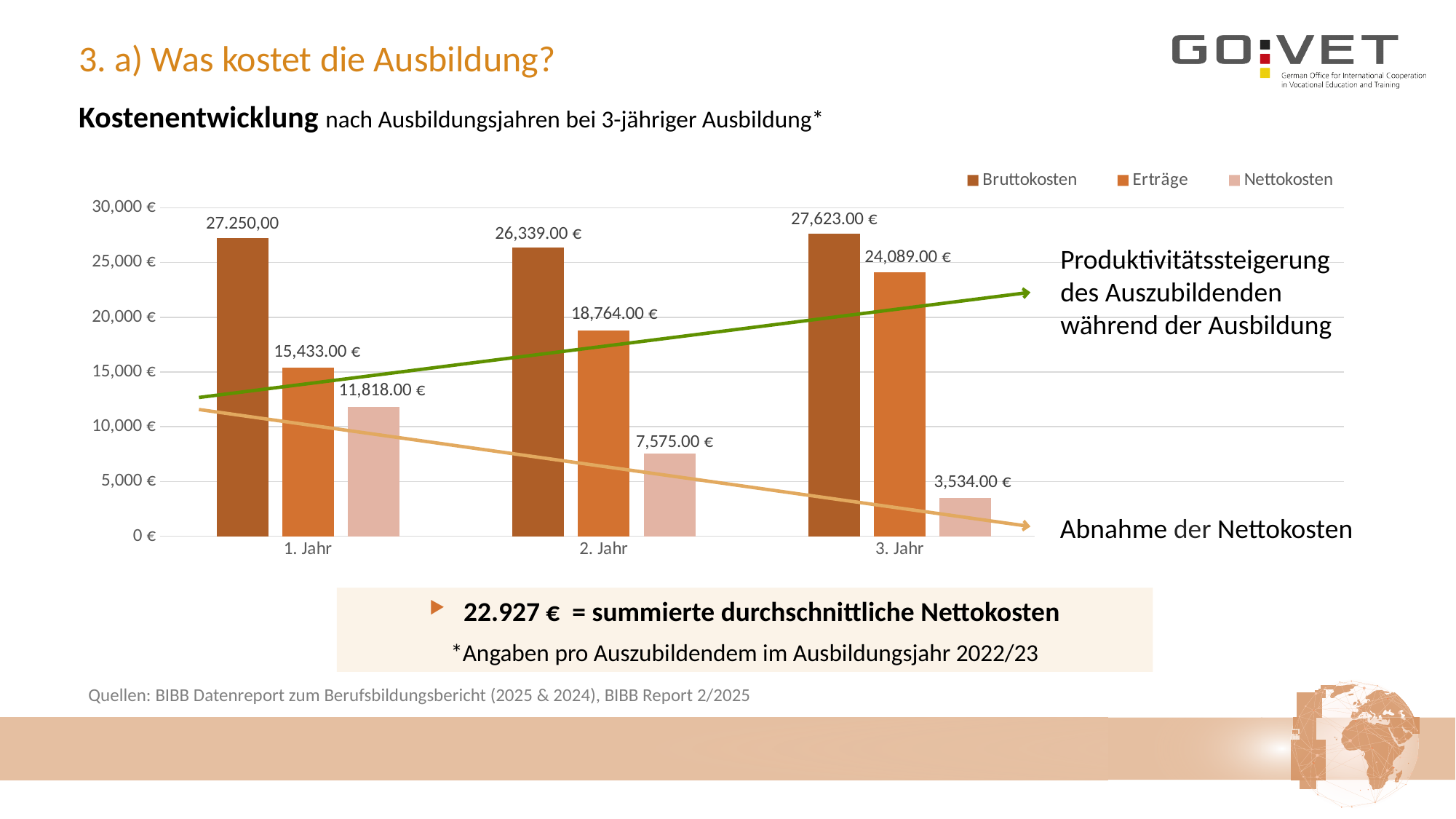
How many years (categories) are shown on the x axis? 3 Which is larger in 2. Jahr: Erträge or Nettokosten? Erträge Do the Nettokosten rise or fall from 1. Jahr to 3. Jahr? fall In which year are the Erträge highest? 3. Jahr What is the difference between Nettokosten in 1. Jahr and Nettokosten in 3. Jahr? 8,284.00 € In which year are the Nettokosten lowest? 3. Jahr What is the value of Bruttokosten in 2. Jahr? 26,339.00 € What is the difference between Erträge in 3. Jahr and Erträge in 1. Jahr? 8,656.00 € What is the value of Nettokosten in 3. Jahr? 3,534.00 € How many series does the legend list? 3 What is the value of Erträge in 2. Jahr? 18,764.00 € Is the value for Nettokosten in 2. Jahr greater or less than 10,000 €? less